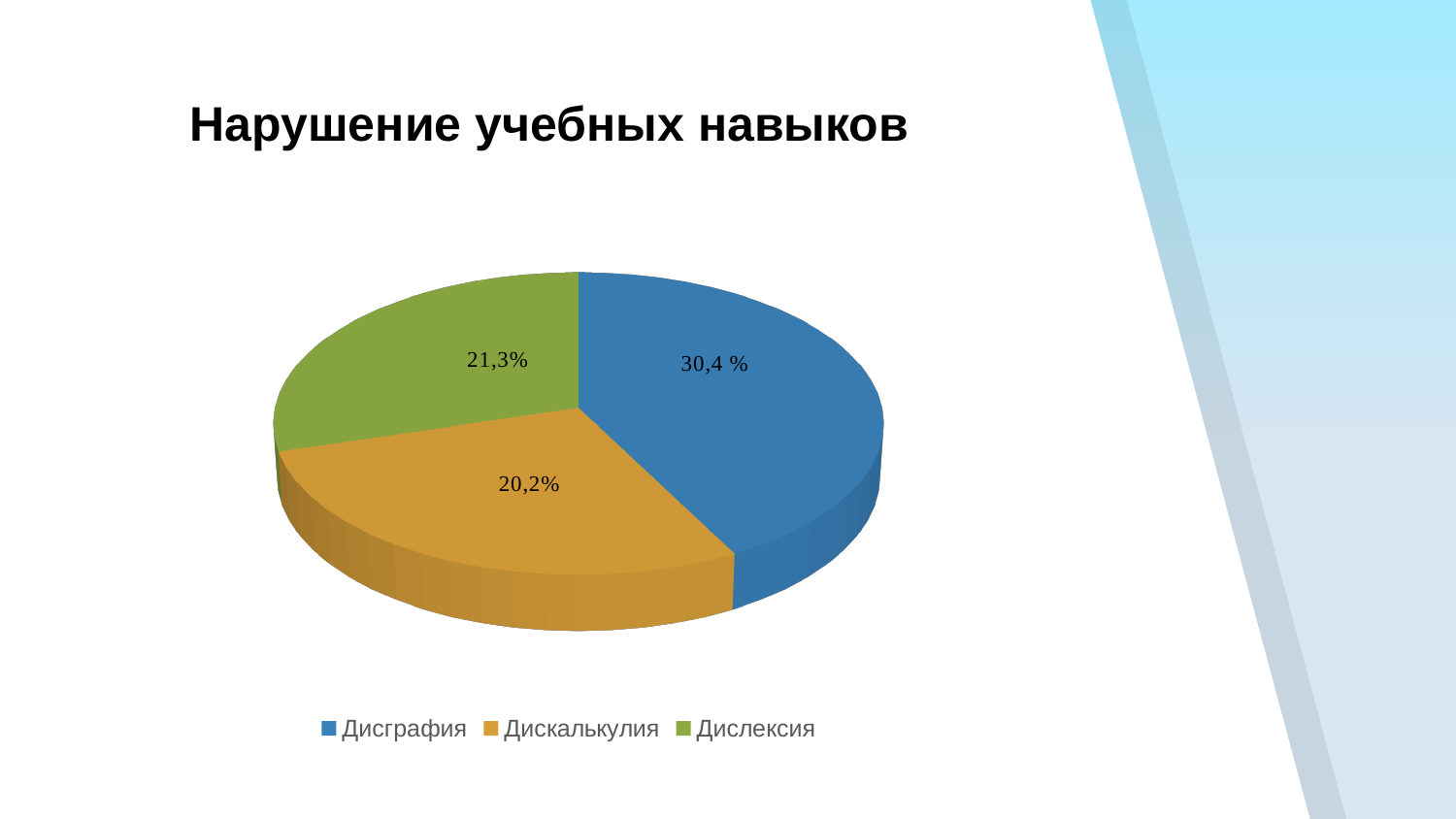
What value is shown for Дислексия? 21,3% Which category has the largest slice of the pie? Дисграфия What value is shown for Дискалькулия? 20,2% Which category has the smallest slice of the pie? Дискалькулия What value is shown for Дисграфия? 30,4 % What is the difference between the values for Дисграфия and Дискалькулия? 10,2 What colour is the slice for Дисграфия? blue What is the difference between the values for Дислексия and Дискалькулия? 1,1 What kind of chart is shown on the slide? pie chart Which is larger, the value for Дислексия or the value for Дискалькулия? Дислексия What is the title of the chart? Нарушение учебных навыков How many slices does the pie chart have? 3